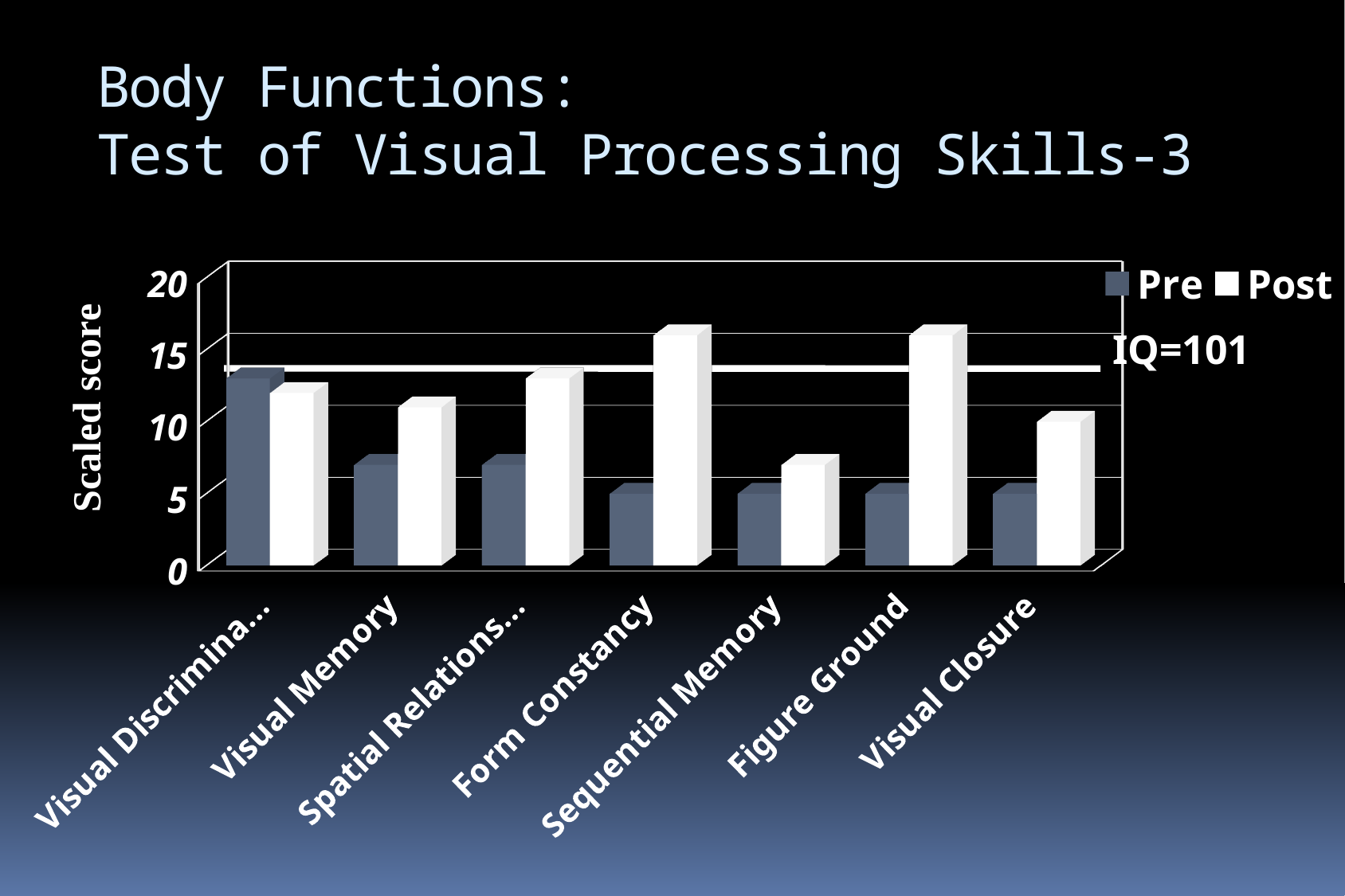
For Form Constancy, which is larger, the Pre value or the Post value? Post Is the Post value for Figure Ground greater or less than 10? greater For Visual Memory, which is larger, the Pre value or the Post value? Post Is the Pre value for Visual Discrimination greater or less than 10? greater Which category has the lowest Post value? Sequential Memory Is the Post value for Form Constancy greater or less than 10? greater What kind of chart is shown on the slide? bar chart Which category has the highest Pre value? Visual Discrimination How many categories are plotted along the x axis? 7 How many series does the legend list? 2 What is the label on the vertical axis of the chart? Scaled score